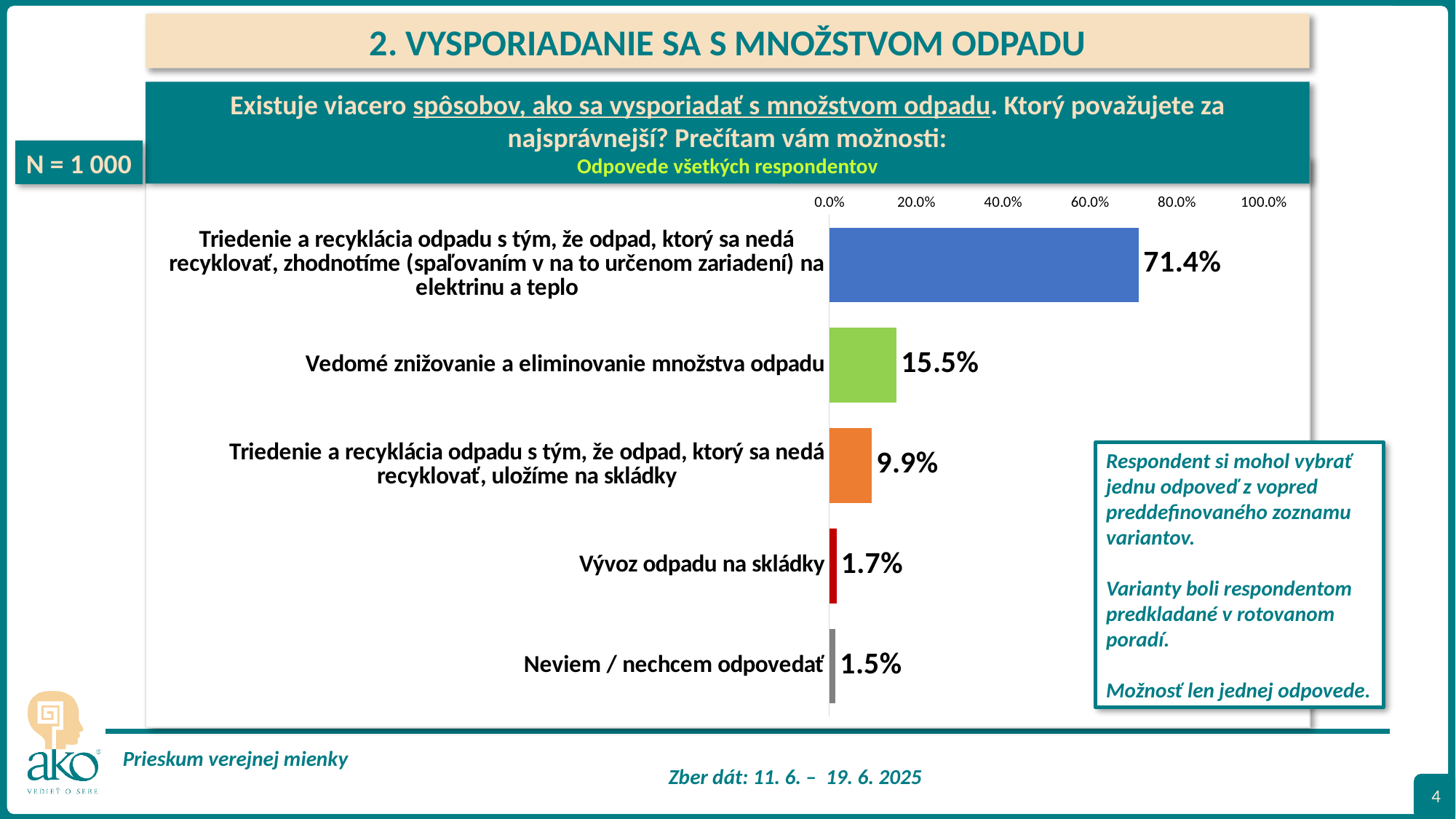
Which is larger: the value for "Vedomé znižovanie a eliminovanie množstva odpadu" or the value for "Triedenie a recyklácia odpadu s tým, že odpad, ktorý sa nedá recyklovať, uložíme na skládky"? Vedomé znižovanie a eliminovanie množstva odpadu What is the difference between the values for "Vývoz odpadu na skládky" and "Neviem / nechcem odpovedať"? 0.2% What percentage of respondents chose "Vedomé znižovanie a eliminovanie množstva odpadu"? 15.5% What is the difference between the highest value (71.4%) and the value for "Vedomé znižovanie a eliminovanie množstva odpadu" (15.5%)? 55.9% Which category has the lowest value in the chart? Neviem / nechcem odpovedať What percentage is shown for "Neviem / nechcem odpovedať"? 1.5% Is the value for the top bar (zhodnotíme na elektrinu a teplo) greater or less than 60.0%? greater What is the value for "Triedenie a recyklácia odpadu s tým, že odpad, ktorý sa nedá recyklovať, uložíme na skládky"? 9.9% Which category has the highest value in the chart? Triedenie a recyklácia odpadu s tým, že odpad, ktorý sa nedá recyklovať, zhodnotíme (spaľovaním v na to určenom zariadení) na elektrinu a teplo What kind of chart is shown on the slide? bar chart What is the value shown for "Vývoz odpadu na skládky"? 1.7% How many categories are shown in the chart? 5